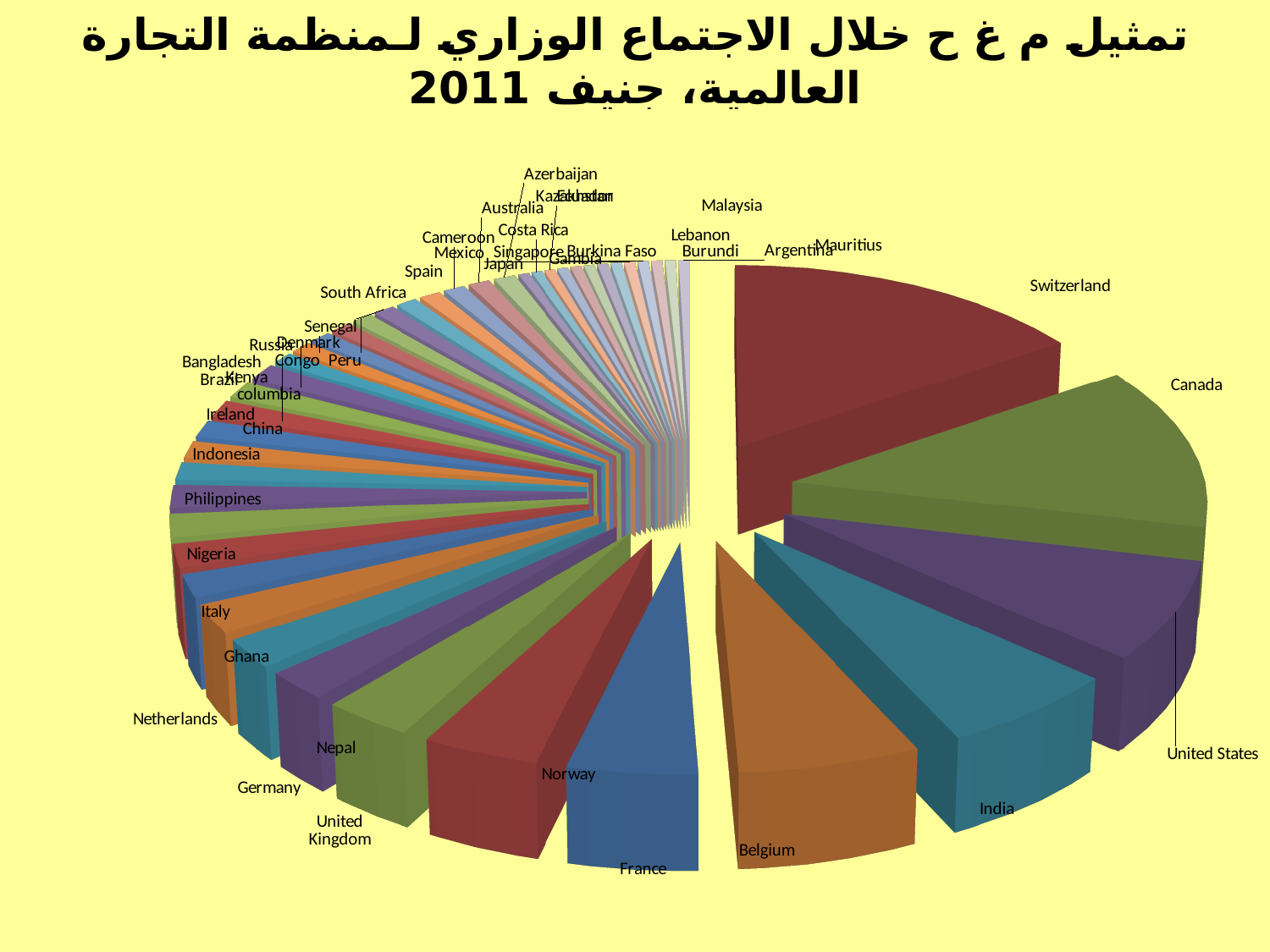
Which of the two slices is larger, India or Philippines? India What colour is the Switzerland slice? dark red Which of the two slices is larger, United States or Italy? United States What kind of chart is shown on the slide? pie chart Which of the two slices is larger, Canada or Ghana? Canada What colour is the Canada slice? green